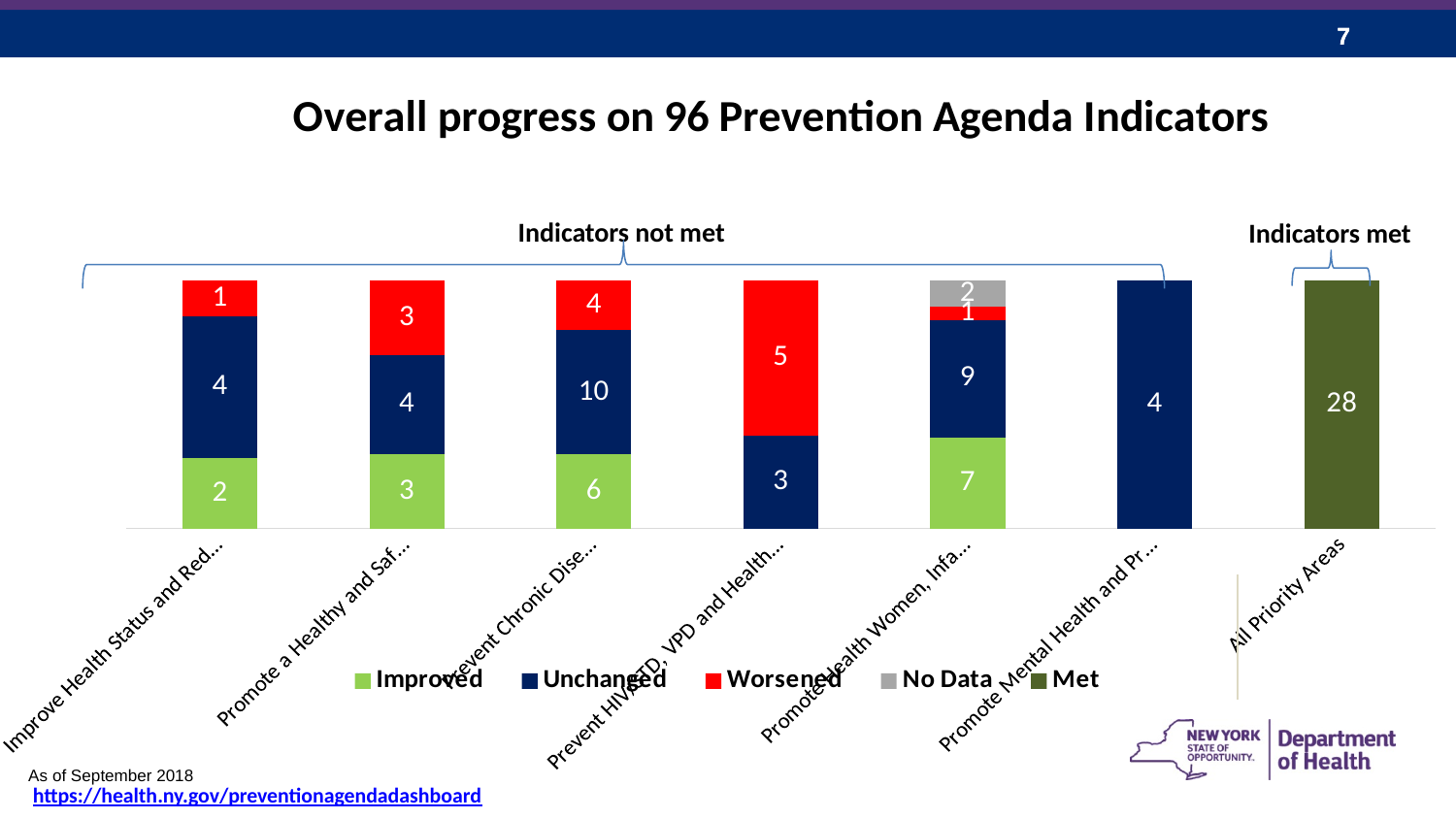
What is the Met value for All Priority Areas? 28 What is the No Data value for the Promote Healthy Women, Infants category? 2 What is the Unchanged value for the Prevent Chronic Disease category? 10 What kind of chart is shown on the slide? stacked bar chart What is the difference between the Unchanged values for Prevent Chronic Disease and Improve Health Status? 6 Which category has the highest Improved value? Promote Healthy Women, Infants What is the Worsened value for the Prevent HIV/STD, VPD category? 5 How many categories are shown along the x axis? 7 What is the total of the stacked bar for the Promote Healthy Women, Infants category? 19 How many series does the legend list? 5 What is the total of the stacked bar for the Promote a Healthy and Safe category? 10 Which is larger: the Worsened value for Prevent Chronic Disease or the Worsened value for Promote a Healthy and Safe? Prevent Chronic Disease